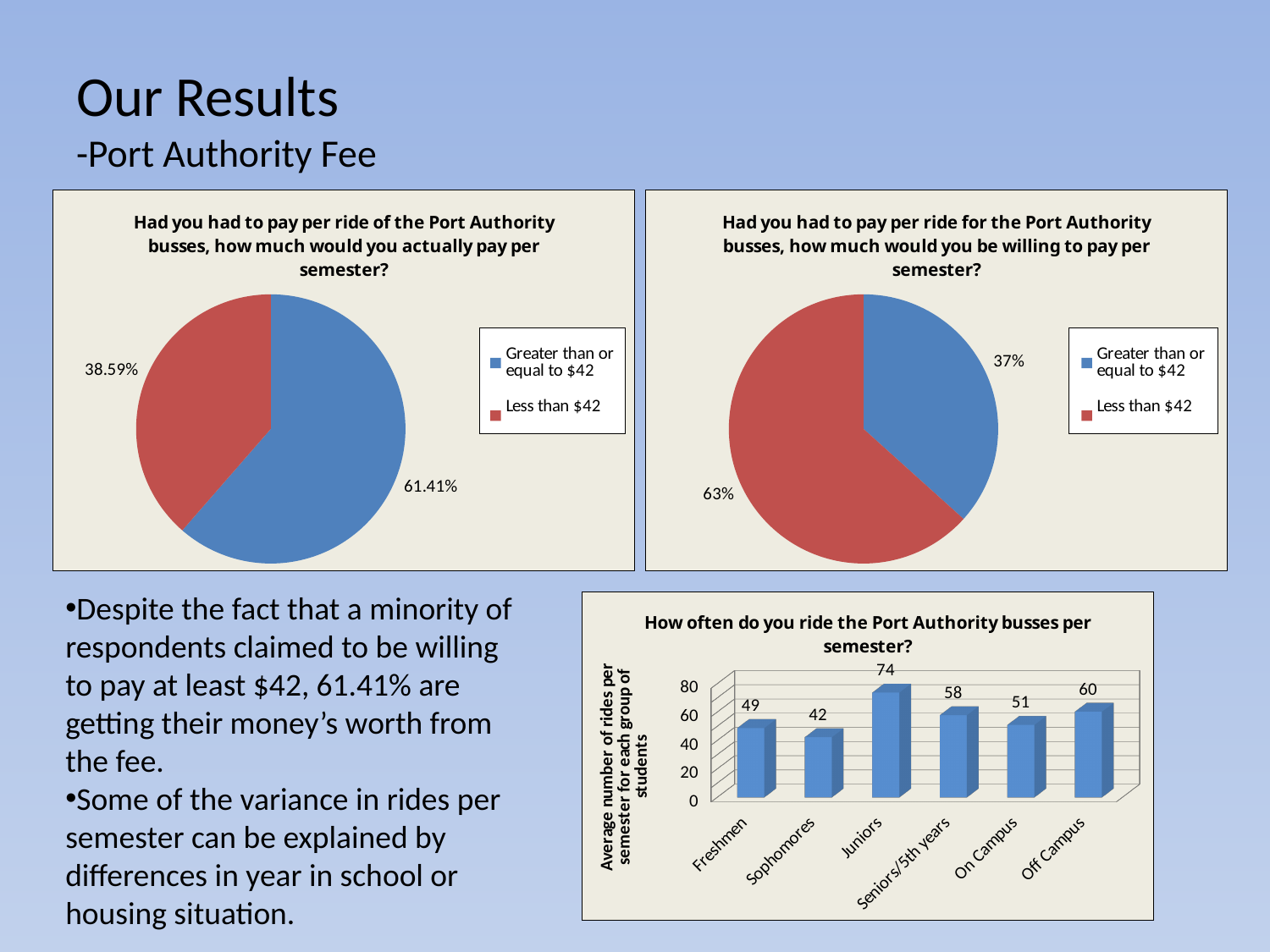
In the right pie chart (how much would you be willing to pay per semester), what share is 'Less than $42'? 63% In the left pie chart (how much would you actually pay per semester), what share is 'Less than $42'? 38.59% How many categories are shown in the bar chart 'How often do you ride the Port Authority busses per semester?' 6 In the bar chart 'How often do you ride the Port Authority busses per semester?', which category has the lowest value? Sophomores In the bar chart 'How often do you ride the Port Authority busses per semester?', which category has the highest value? Juniors In the bar chart 'How often do you ride the Port Authority busses per semester?', what is the value for Juniors? 74 In the bar chart 'How often do you ride the Port Authority busses per semester?', which is larger, the value for Seniors/5th years or On Campus? Seniors/5th years In the bar chart 'How often do you ride the Port Authority busses per semester?', what is the value for Off Campus? 60 In the left pie chart (how much would you actually pay per semester), what share is 'Greater than or equal to $42'? 61.41% What kind of chart is 'How often do you ride the Port Authority busses per semester?' Bar chart In the bar chart 'How often do you ride the Port Authority busses per semester?', what is the difference between the values for Juniors and Freshmen? 25 How many entries does the legend of the right pie chart (how much would you be willing to pay per semester) list? 2